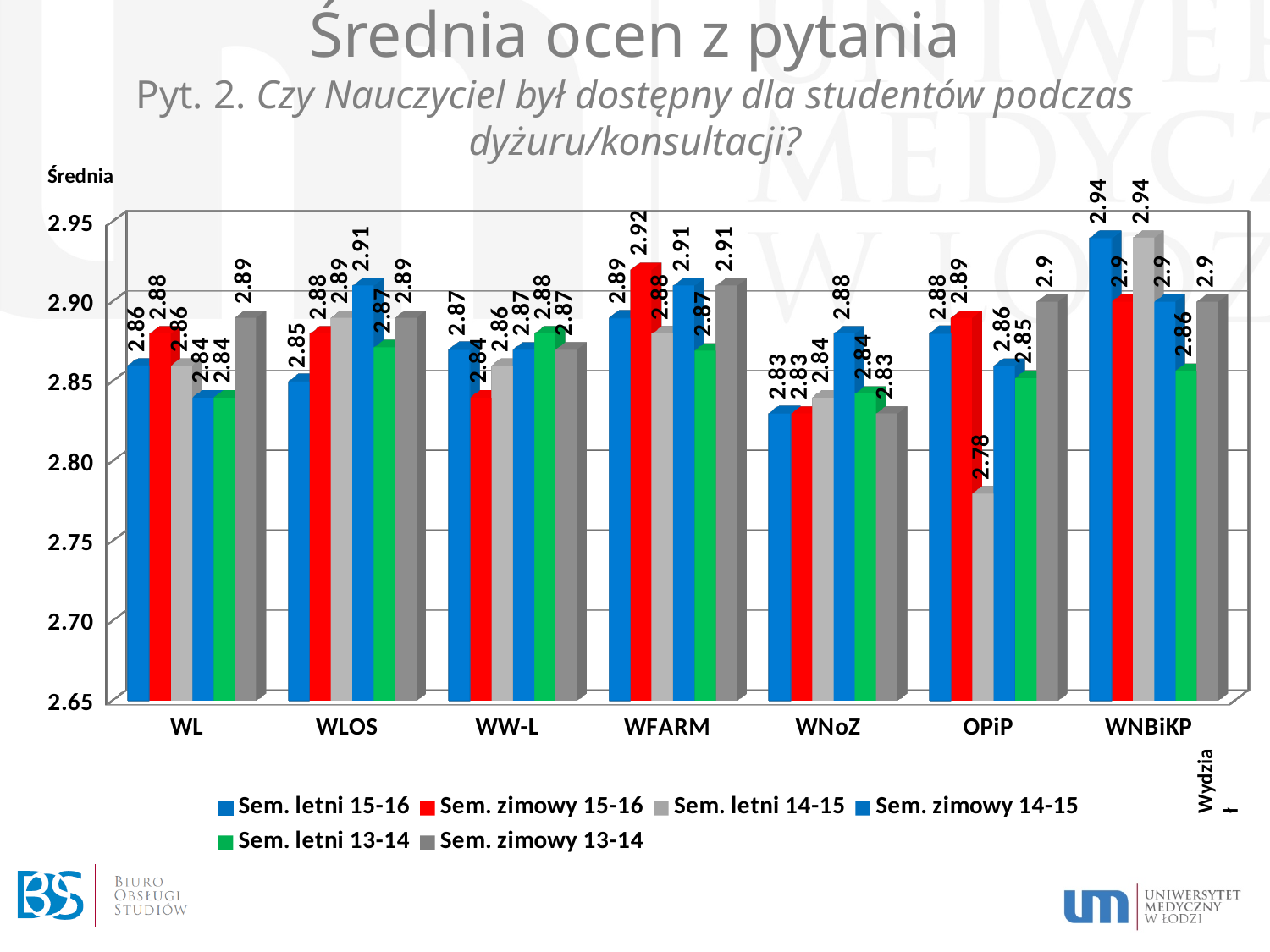
Which is larger: the Sem. letni 13-14 value for WW-L or for WL? WW-L How many categories (faculties) are shown on the x axis? 7 What is the value of Sem. zimowy 13-14 for WNoZ? 2.83 Is the Sem. letni 14-15 value for OPiP greater or less than 2.80? less Which category has the highest value in the Sem. zimowy 15-16 series? WFARM What kind of chart is shown on the slide? bar chart What is the label of the vertical axis? Średnia What is the value of Sem. zimowy 15-16 for WFARM? 2.92 Which category has the lowest value in the Sem. letni 14-15 series? OPiP What is the value of Sem. letni 14-15 for OPiP? 2.78 What is the difference between the Sem. zimowy 15-16 values for WFARM and WNoZ? 0.09 How many series does the legend list? 6